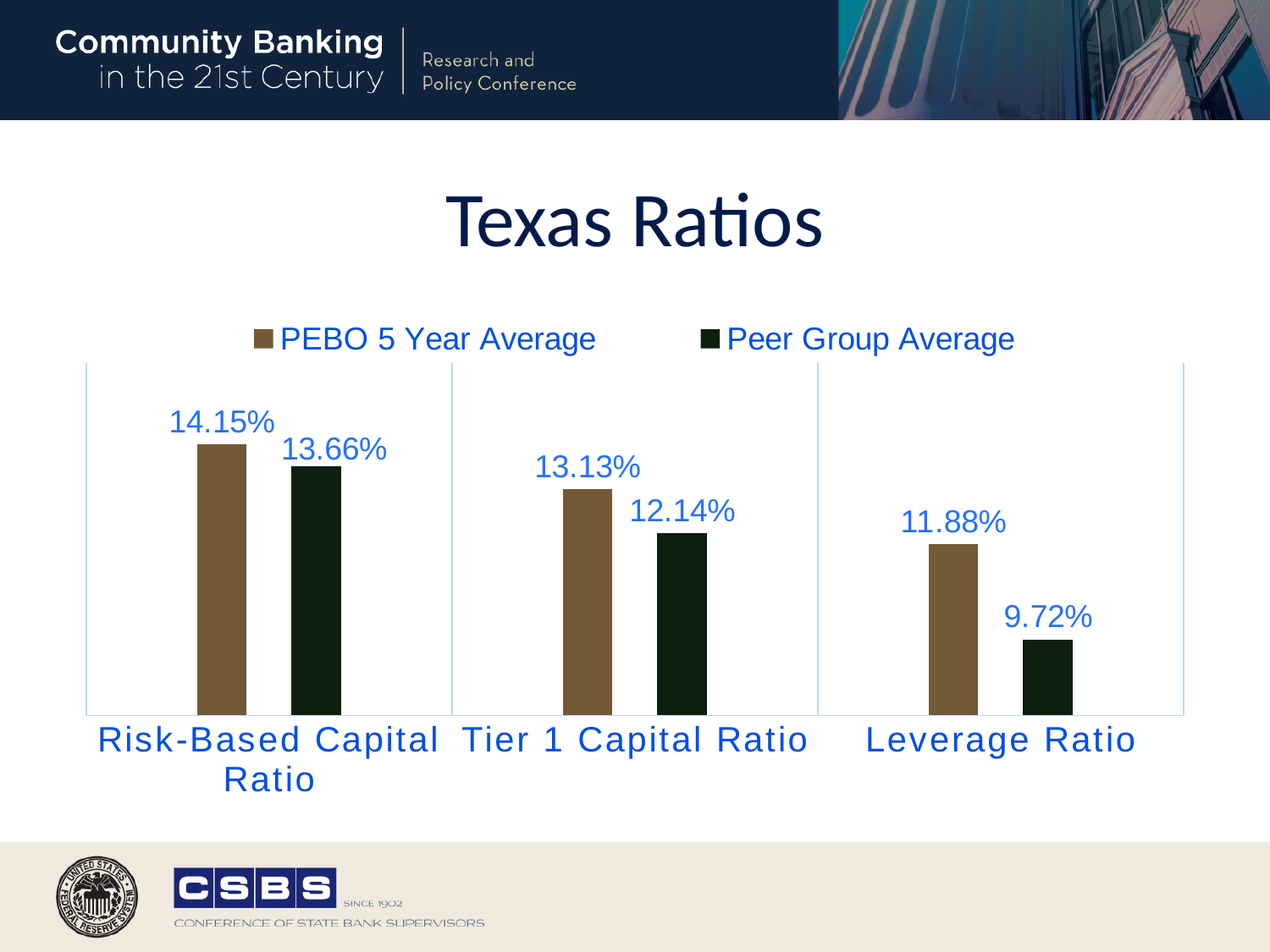
What is the difference between the PEBO 5 Year Average and the Peer Group Average for Risk-Based Capital Ratio? 0.49% How many categories are shown on the x axis? 3 Which category has the lowest Peer Group Average? Leverage Ratio How many series does the legend list? 2 For Tier 1 Capital Ratio, which is larger: the PEBO 5 Year Average or the Peer Group Average? PEBO 5 Year Average What is the PEBO 5 Year Average for Tier 1 Capital Ratio? 13.13% Which category has the highest PEBO 5 Year Average? Risk-Based Capital Ratio What is the Peer Group Average for Tier 1 Capital Ratio? 12.14% What kind of chart is shown on the slide? Bar chart What is the difference between the PEBO 5 Year Average and the Peer Group Average for Leverage Ratio? 2.16% What is the Peer Group Average for Leverage Ratio? 9.72% What is the PEBO 5 Year Average for Risk-Based Capital Ratio? 14.15%